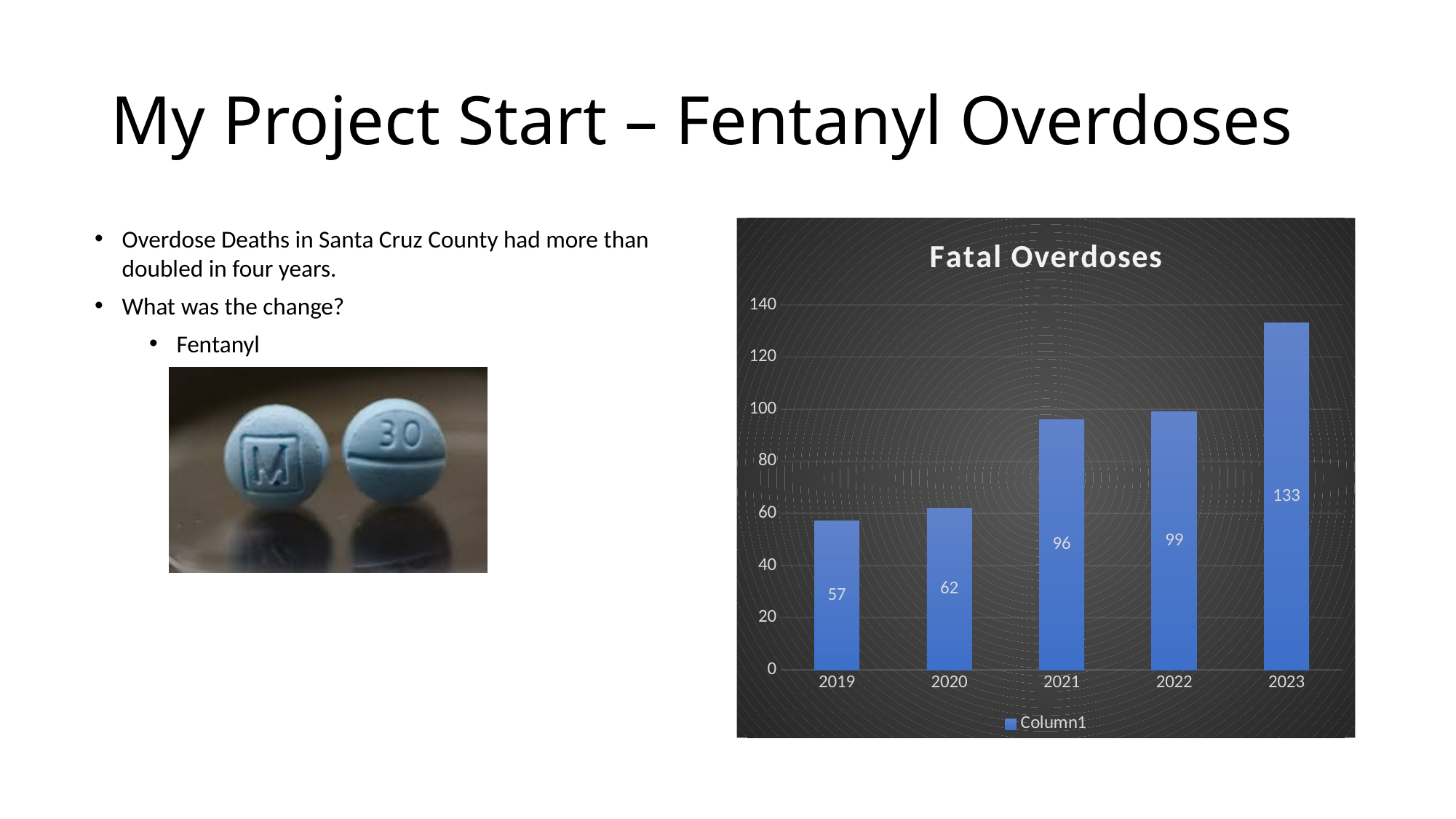
Which year has the lowest value in the Fatal Overdoses chart? 2019 What is the difference between the 2022 and 2021 values in the Fatal Overdoses chart? 3 What is the difference between the 2023 and 2019 values in the Fatal Overdoses chart? 76 Which year has the highest value in the Fatal Overdoses chart? 2023 What is the value for 2023 in the Fatal Overdoses chart? 133 Do the values in the Fatal Overdoses chart rise or fall from 2019 to 2023? rise What kind of chart is the Fatal Overdoses chart? bar chart What is the value for 2019 in the Fatal Overdoses chart? 57 Which is larger in the Fatal Overdoses chart, the value for 2020 or the value for 2021? 2021 Is the value for 2023 in the Fatal Overdoses chart greater or less than 120? greater How many years are shown in the Fatal Overdoses chart? 5 What is the value for 2021 in the Fatal Overdoses chart? 96